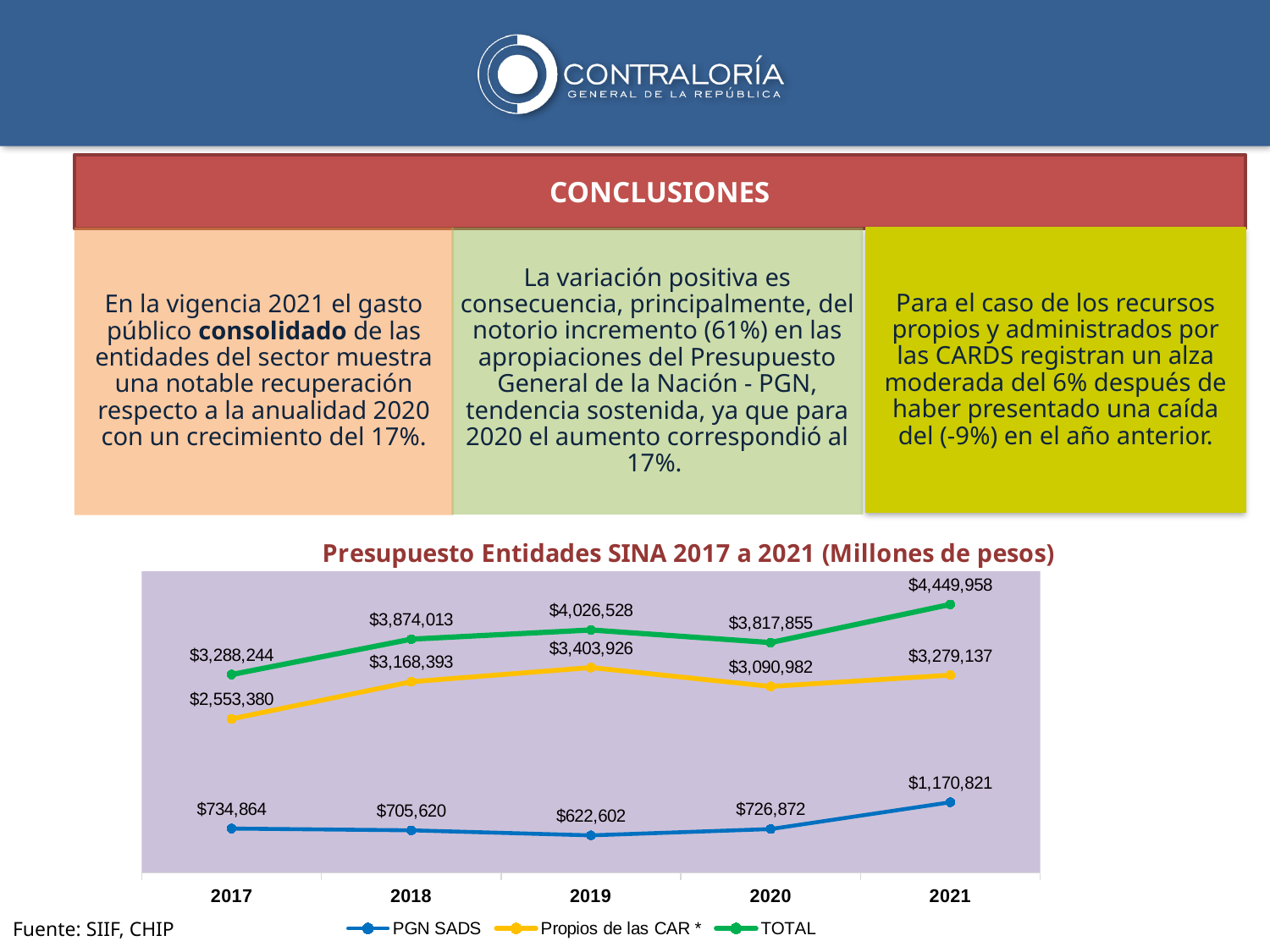
How many series does the chart legend list? 3 In which year is the TOTAL series highest? 2021 What is the value of 'Propios de las CAR *' in 2018? $3,168,393 What is the PGN SADS value for 2019? $622,602 How many years are plotted on the x axis of the chart? 5 By how much did the TOTAL value increase from 2017 to 2021? $1,161,714 What is the difference between the PGN SADS values for 2021 and 2020? $443,949 What is the TOTAL value for 2021 in the chart 'Presupuesto Entidades SINA 2017 a 2021'? $4,449,958 Does the PGN SADS series rise or fall from 2020 to 2021? Rise In which year is the PGN SADS series lowest? 2019 Which is larger, the 'Propios de las CAR *' value in 2019 or in 2021? 2019 What type of chart is shown on the slide? Line chart